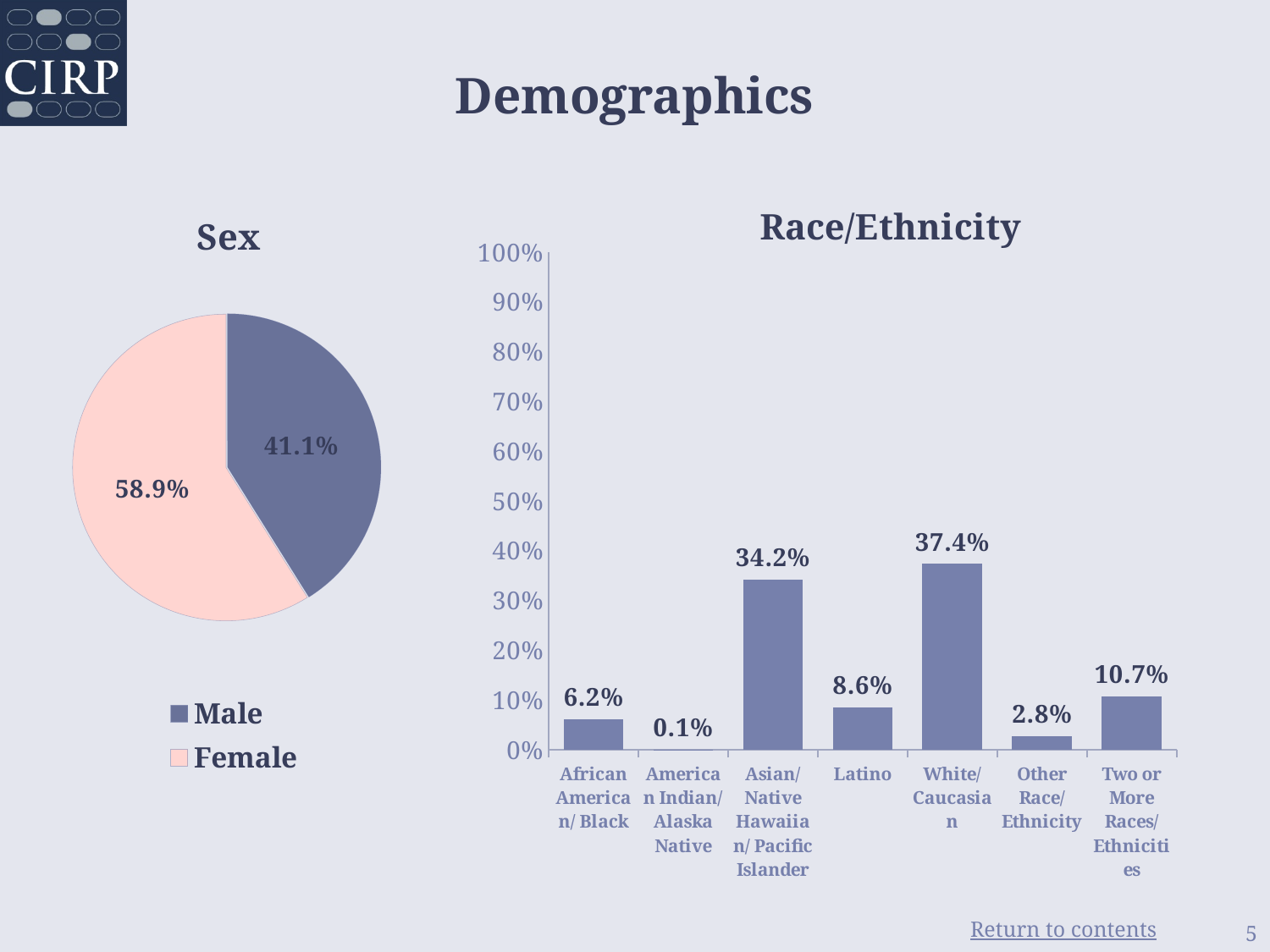
In the Sex chart, which category has the larger share, Male or Female? Female In the Sex chart, what is the difference between the Female and Male percentages? 17.8% In the Race/Ethnicity chart, which category has the lowest value? American Indian/Alaska Native In the Race/Ethnicity chart, which category has the highest value? White/Caucasian What kind of chart is the Race/Ethnicity chart? bar chart In the Race/Ethnicity chart, how many categories are shown? 7 In the Race/Ethnicity chart, what is the value for Asian/Native Hawaiian/Pacific Islander? 34.2% In the Sex chart, what percentage is Male? 41.1% In the Race/Ethnicity chart, what is the value for Latino? 8.6% In the Race/Ethnicity chart, what is the difference between White/Caucasian and Asian/Native Hawaiian/Pacific Islander? 3.2% What kind of chart is the Sex chart? pie chart In the Sex chart, what percentage is Female? 58.9%